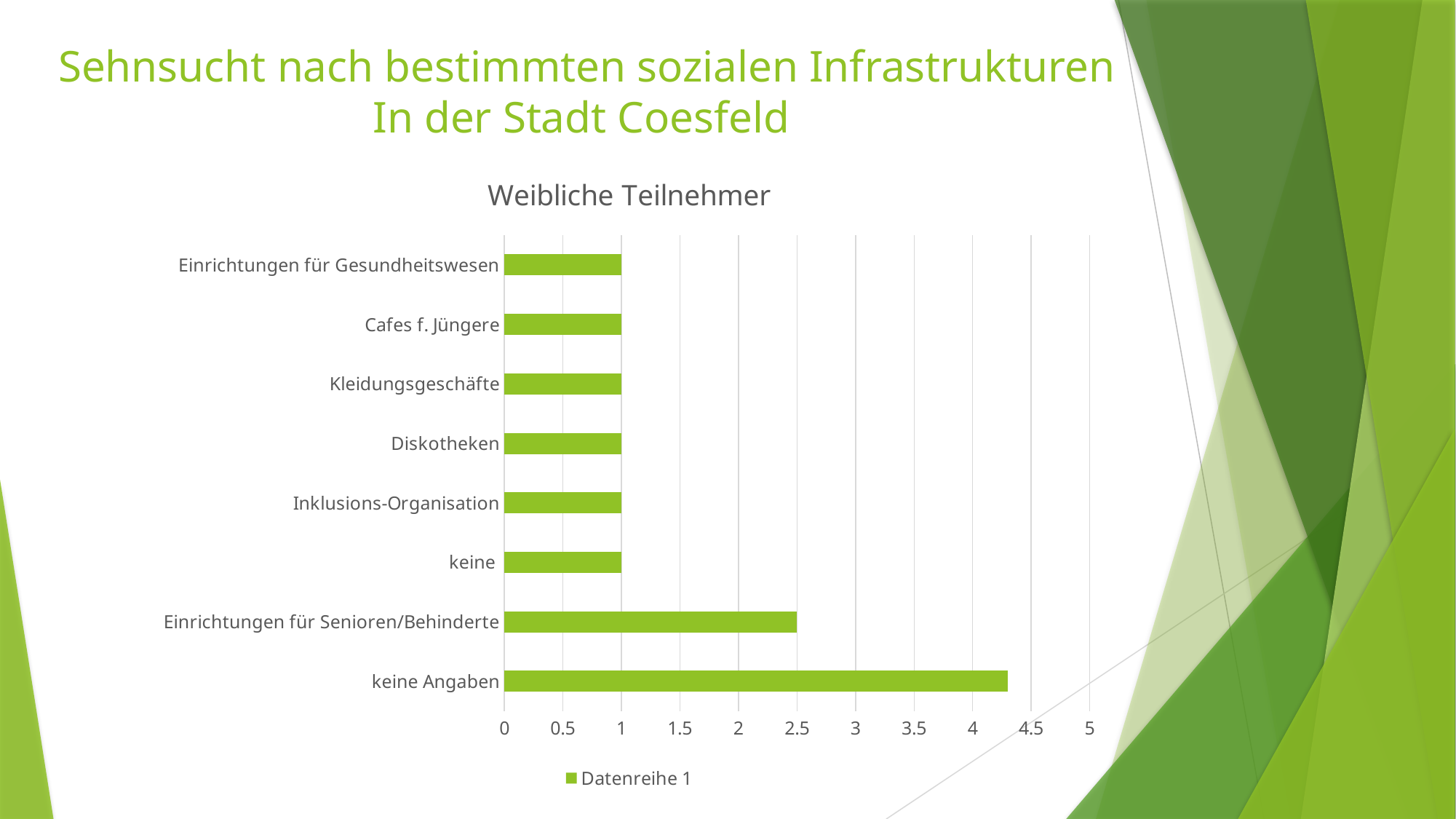
Which category has the highest value? keine Angaben What type of chart is shown on the slide? bar chart What is the title of the chart? Weibliche Teilnehmer Which is larger, the value for Einrichtungen für Senioren/Behinderte or the value for Cafes f. Jüngere? Einrichtungen für Senioren/Behinderte How many categories are plotted in the chart? 8 What is the value for Kleidungsgeschäfte? 1 Is the value for keine Angaben greater or less than 4? greater How many series does the legend list? 1 Is the value for keine Angaben greater or less than 4.5? less What is the value for Einrichtungen für Senioren/Behinderte? 2.5 What is the value for Diskotheken? 1 What is the difference between the value for Einrichtungen für Senioren/Behinderte and the value for Inklusions-Organisation? 1.5